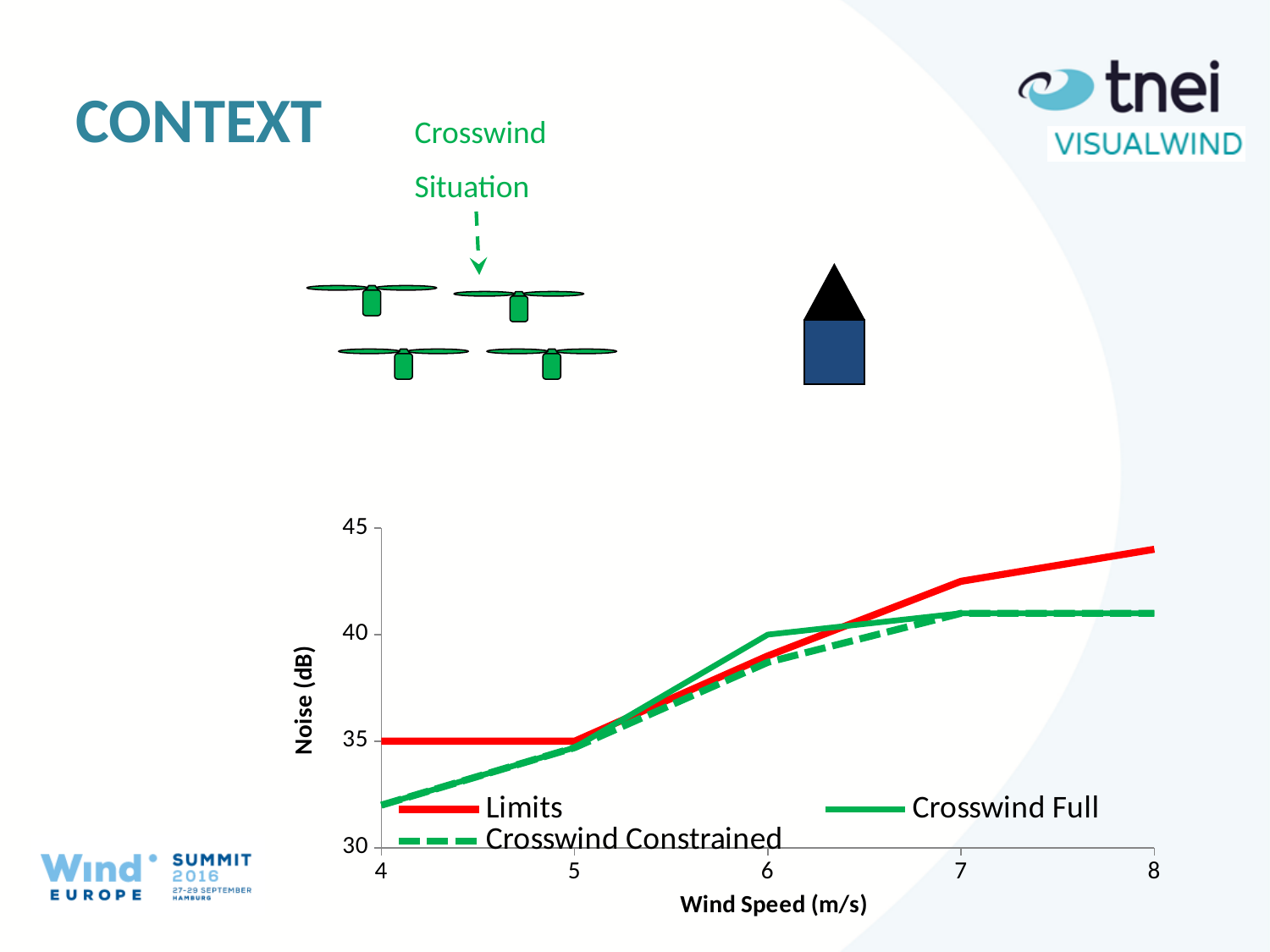
What is the label of the vertical axis? Noise (dB) Is the Crosswind Constrained value at 8 m/s greater or less than 40? greater What is the Limits value at a wind speed of 5 m/s? 35 What is the label of the horizontal axis? Wind Speed (m/s) Is the Crosswind Full value at 4 m/s greater or less than 35? less Is the Limits value at 8 m/s greater or less than 40? greater What kind of chart is shown on the slide? line chart At a wind speed of 4 m/s, which series has the higher value: Limits or Crosswind Full? Limits How many series does the chart legend list? 3 Does the Limits series rise or fall as wind speed increases from 5 to 8 m/s? rise At a wind speed of 8 m/s, which series has the higher value: Limits or Crosswind Full? Limits What is the Limits value at a wind speed of 4 m/s? 35